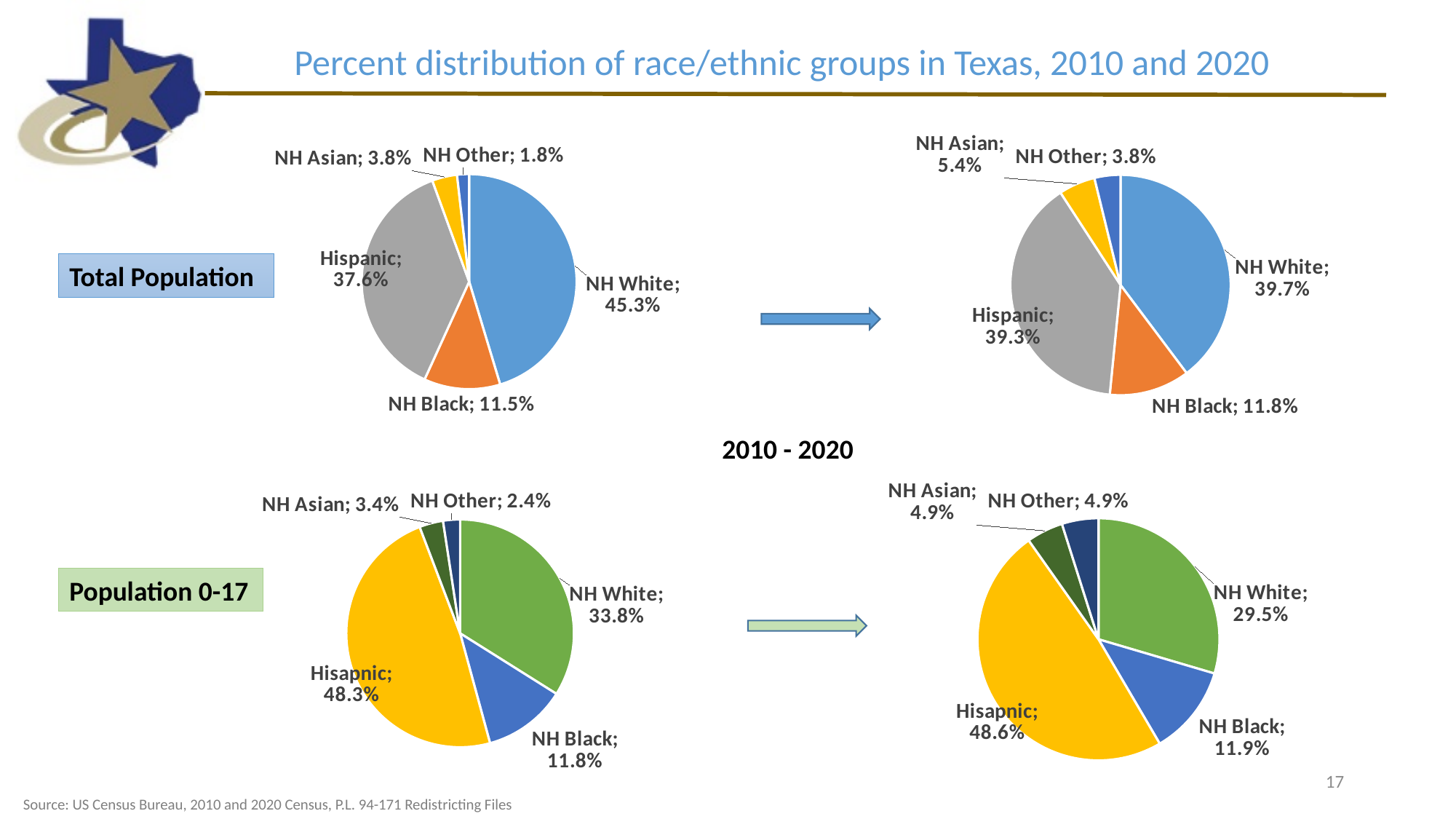
What is the difference between the NH White share in the Total Population 2010 pie chart (top left) and the NH White share in the Total Population 2020 pie chart (top right)? 5.6% In the Total Population 2020 pie chart (top right), which is larger: the NH White share or the Hispanic share? NH White In the Population 0-17 2020 pie chart (bottom right), what is the share for NH White? 29.5% In the Total Population 2010 pie chart (top left), what is the share for NH White? 45.3% In the Total Population 2020 pie chart (top right), which group has the smallest share? NH Other In the Total Population 2020 pie chart (top right), what is the share for Hispanic? 39.3% In the Population 0-17 2020 pie chart (bottom right), what is the difference between the Hisapnic share and the NH White share? 19.1% In the Population 0-17 2010 pie chart (bottom left), which group has the largest share? Hisapnic In the Total Population 2010 pie chart (top left), which group has the smallest share? NH Other How many slices does the Population 0-17 2010 pie chart (bottom left) have? 5 What type of chart is used for the Total Population 2010 data (top left)? Pie chart What is the title of the slide? Percent distribution of race/ethnic groups in Texas, 2010 and 2020